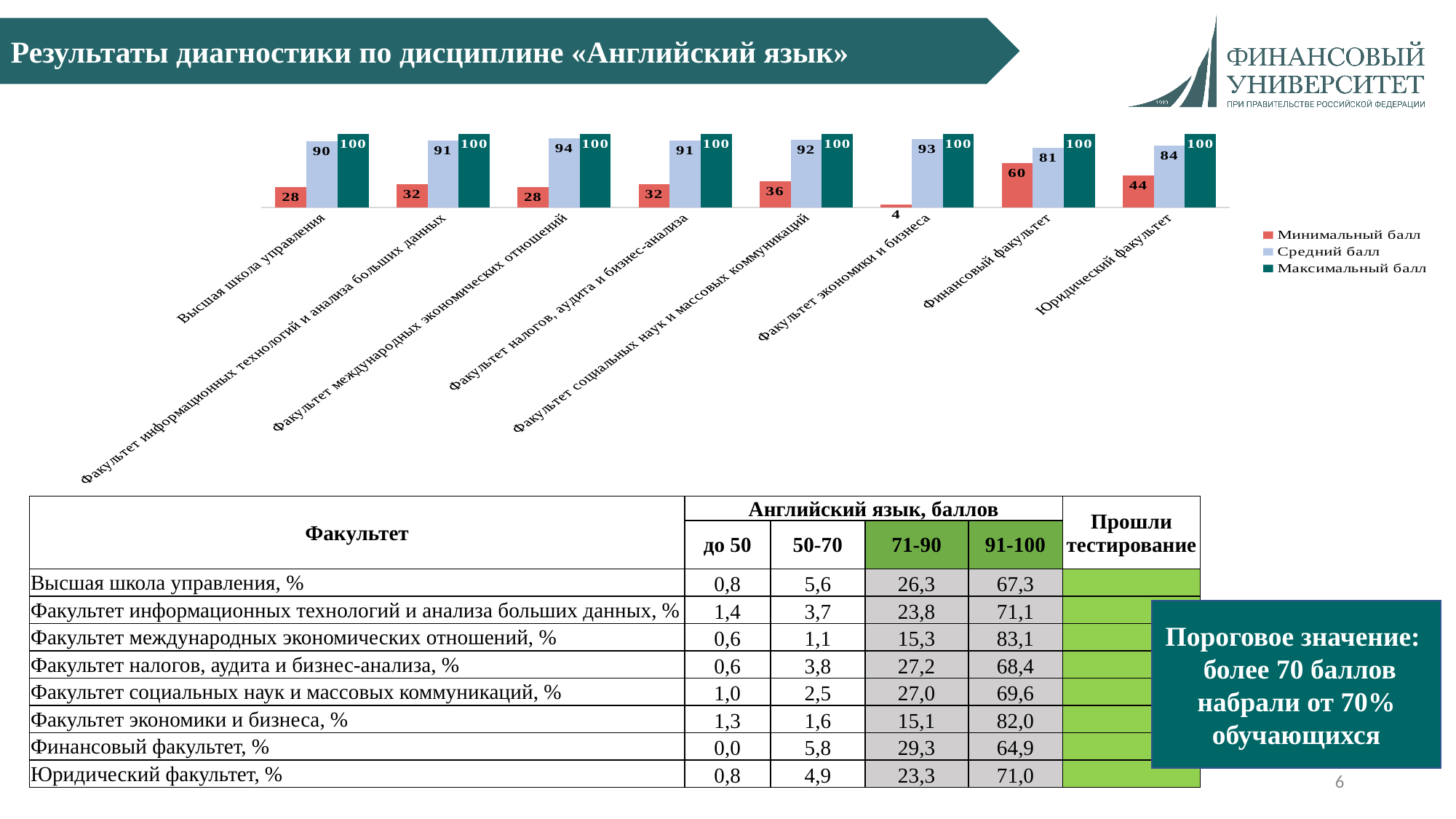
Which faculty has the lowest average score (Средний балл)? Финансовый факультет What is the average score (Средний балл) for Факультет международных экономических отношений? 94 What is the difference between the average score and the minimum score for Юридический факультет? 40 How many faculties are shown on the x axis of the chart? 8 Which faculty has the lowest minimum score (Минимальный балл)? Факультет экономики и бизнеса What is the minimum score (Минимальный балл) for Факультет экономики и бизнеса? 4 What type of chart is shown on the slide? bar chart Which is larger: the minimum score for Факультет социальных наук и массовых коммуникаций or for Высшая школа управления? Факультет социальных наук и массовых коммуникаций Which faculty has the highest minimum score (Минимальный балл)? Финансовый факультет What is the minimum score (Минимальный балл) for Финансовый факультет? 60 What is the maximum score (Максимальный балл) for every faculty in the chart? 100 How many series does the chart legend list? 3